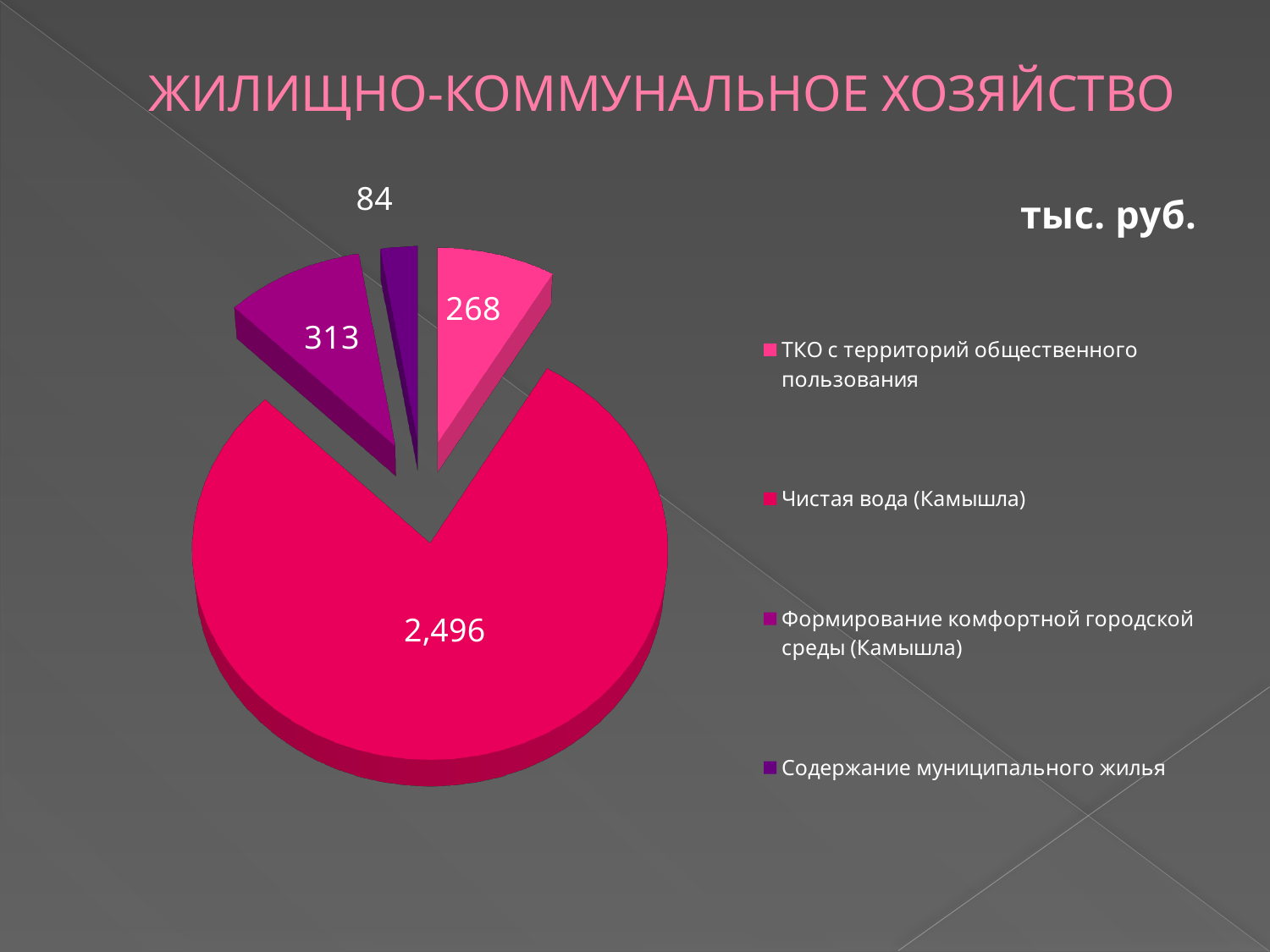
Which is larger: the value for Формирование комфортной городской среды (Камышла) or the value for ТКО с территорий общественного пользования? Формирование комфортной городской среды (Камышла) What is the value for ТКО с территорий общественного пользования? 268 What is the value for Чистая вода (Камышла)? 2,496 What is the difference between the values for Чистая вода (Камышла) and Формирование комфортной городской среды (Камышла)? 2,183 What kind of chart is shown on the slide? pie chart What unit is indicated for the values on the chart? тыс. руб. How many entries does the legend list? 4 What is the value for Формирование комфортной городской среды (Камышла)? 313 How many slices does the pie chart have? 4 Which category has the smallest slice? Содержание муниципального жилья Which category has the largest slice? Чистая вода (Камышла) What is the value for Содержание муниципального жилья? 84